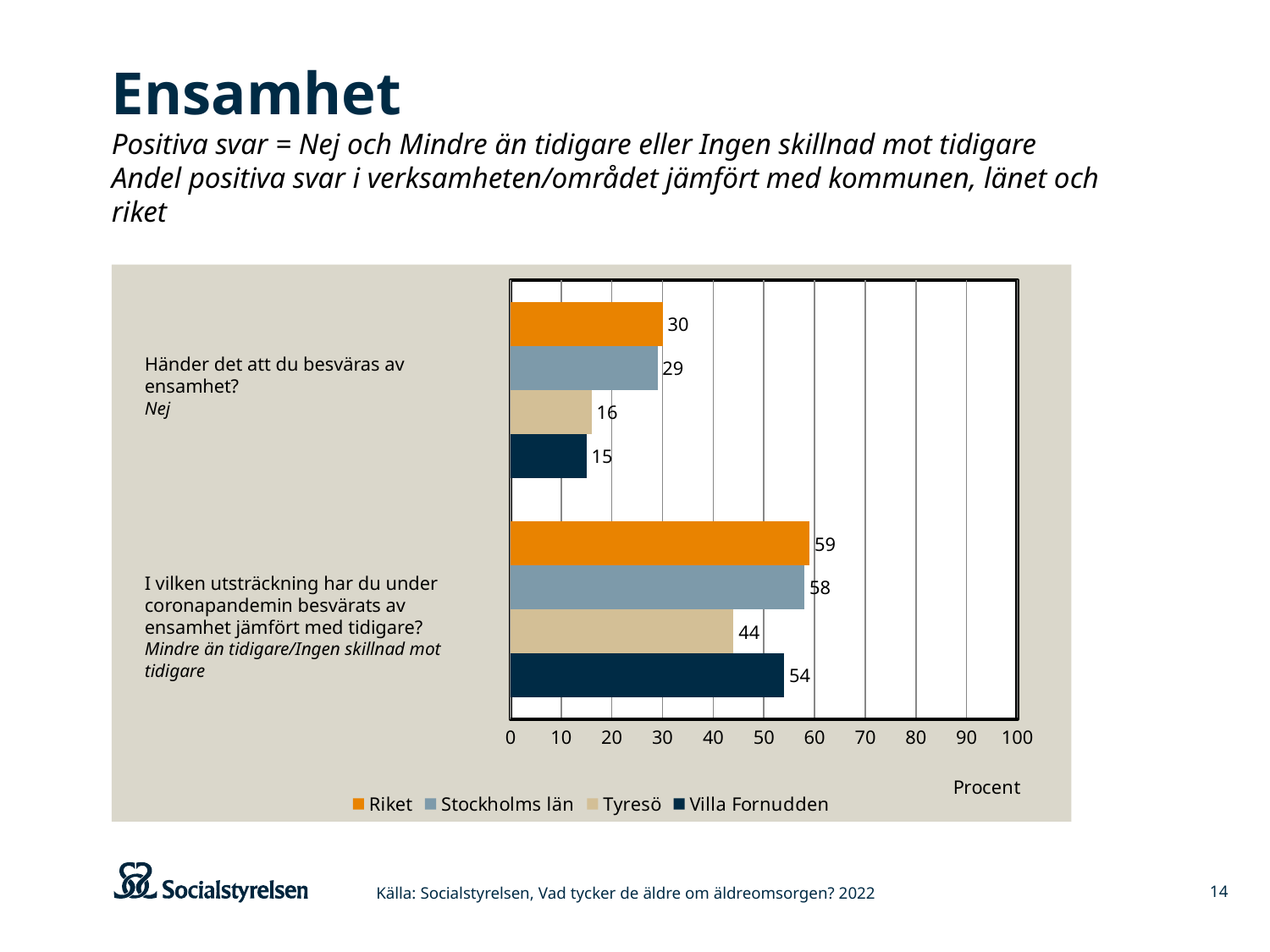
What kind of chart is shown on the slide? Bar chart What is the difference between Riket and Villa Fornudden on the question 'Händer det att du besväras av ensamhet?' 15 What unit is shown on the x axis of the chart? Procent Which series has the lowest value on the question 'Händer det att du besväras av ensamhet?' Villa Fornudden What is the value for Villa Fornudden on the question 'I vilken utsträckning har du under coronapandemin besvärats av ensamhet jämfört med tidigare?' 54 Is the value for Stockholms län on the question 'I vilken utsträckning har du under coronapandemin besvärats av ensamhet jämfört med tidigare?' greater or less than 50? greater How many series does the legend list? 4 What is the difference between Villa Fornudden and Tyresö on the question 'I vilken utsträckning har du under coronapandemin besvärats av ensamhet jämfört med tidigare?' 10 What is the value for Riket on the question 'Händer det att du besväras av ensamhet?' 30 What is the value for Tyresö on the question 'Händer det att du besväras av ensamhet?' 16 Which series has the highest value on the question 'I vilken utsträckning har du under coronapandemin besvärats av ensamhet jämfört med tidigare?' Riket Which is larger on the question 'I vilken utsträckning har du under coronapandemin besvärats av ensamhet jämfört med tidigare?': Stockholms län or Tyresö? Stockholms län